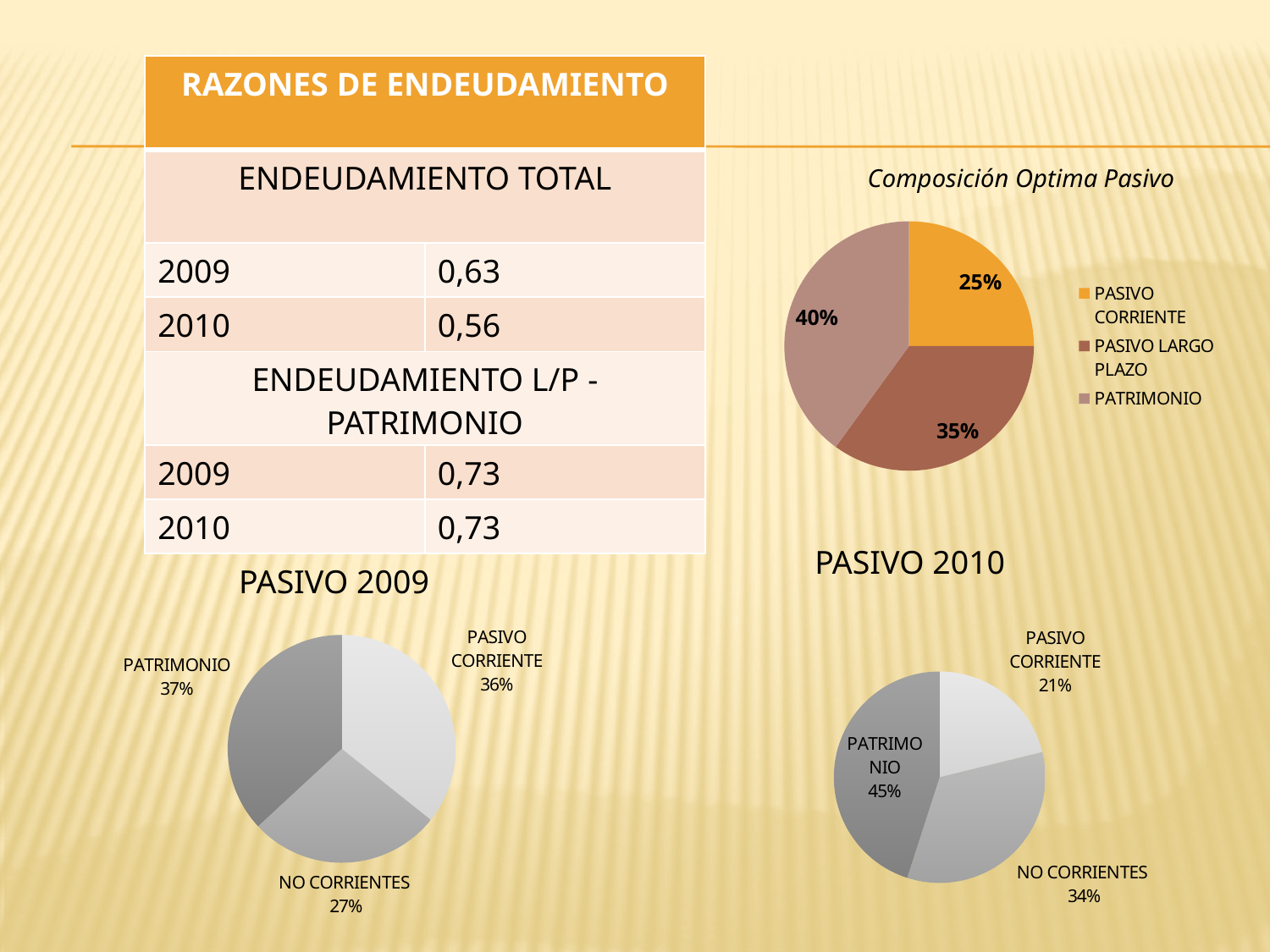
In the 'PASIVO 2009' chart, what share is NO CORRIENTES? 27% What kind of chart is 'PASIVO 2009'? Pie chart In the 'Composición Optima Pasivo' chart, which category has the largest share? PATRIMONIO In the 'PASIVO 2010' chart, how many slices does the pie have? 3 In the 'PASIVO 2010' chart, which is larger, PASIVO CORRIENTE or NO CORRIENTES? NO CORRIENTES In the 'Composición Optima Pasivo' chart, what share is PASIVO CORRIENTE? 25% In the 'PASIVO 2010' chart, which category has the largest share? PATRIMONIO In the 'PASIVO 2009' chart, which category has the smallest share? NO CORRIENTES In the 'PASIVO 2010' chart, what is the difference between the PATRIMONIO share and the PASIVO CORRIENTE share? 24% In the 'Composición Optima Pasivo' chart, how many entries does the legend list? 3 In the 'Composición Optima Pasivo' chart, what is the difference between the PATRIMONIO share and the PASIVO CORRIENTE share? 15% In the 'PASIVO 2010' chart, what share is PATRIMONIO? 45%